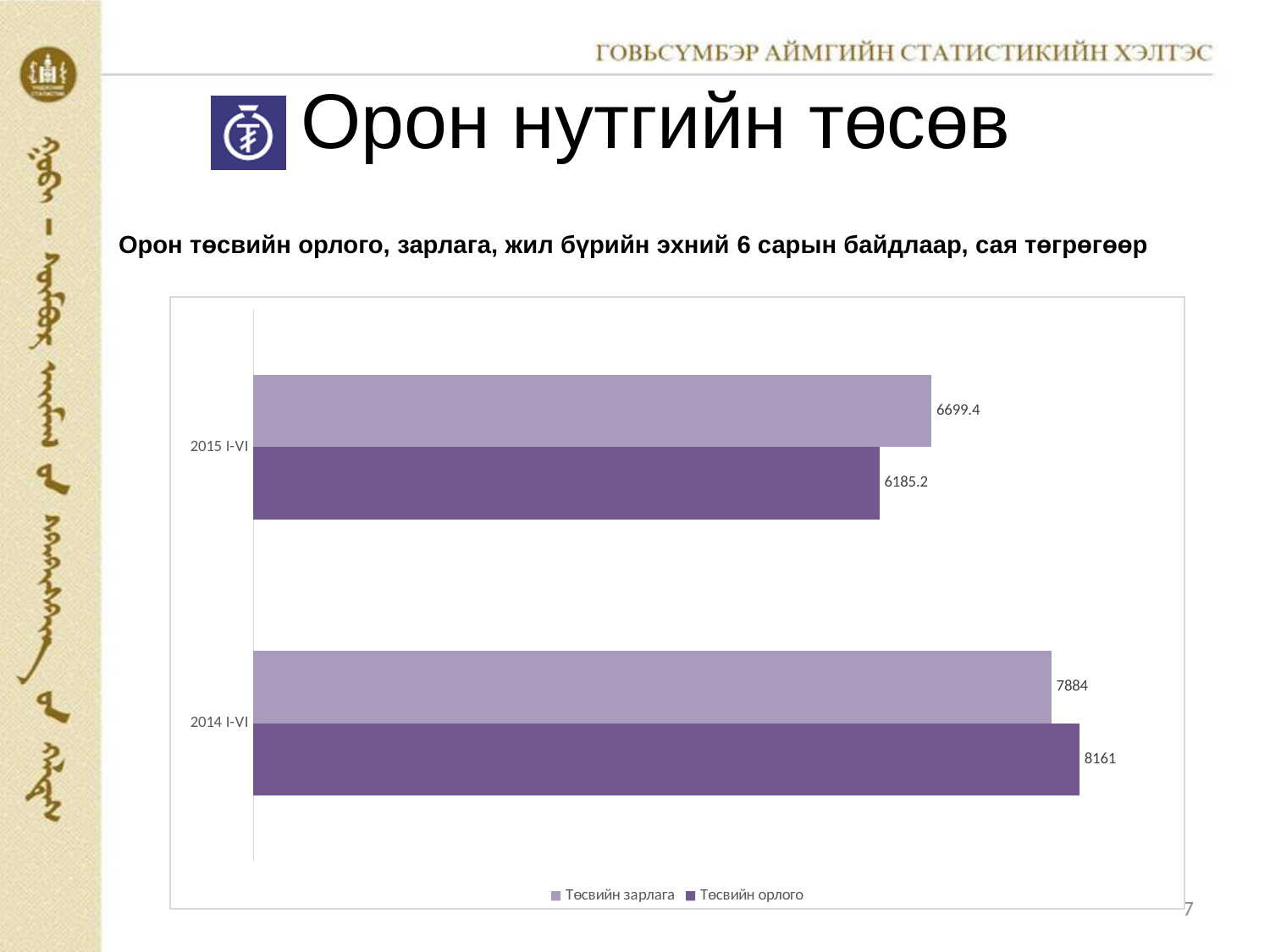
How many series does the legend list? 2 Which period has the higher value for Төсвийн орлого? 2014 I-VI How many periods (categories) are shown on the chart? 2 What type of chart is shown on the slide? bar chart What is the value of Төсвийн орлого for 2015 I-VI? 6185.2 What is the difference between Төсвийн зарлага and Төсвийн орлого for 2015 I-VI? 514.2 Which period has the lower value for Төсвийн зарлага? 2015 I-VI For 2015 I-VI, which is larger: Төсвийн зарлага or Төсвийн орлого? Төсвийн зарлага What is the value of Төсвийн зарлага for 2015 I-VI? 6699.4 What is the difference between Төсвийн орлого and Төсвийн зарлага for 2014 I-VI? 277 What is the value of Төсвийн зарлага for 2014 I-VI? 7884 What is the value of Төсвийн орлого for 2014 I-VI? 8161